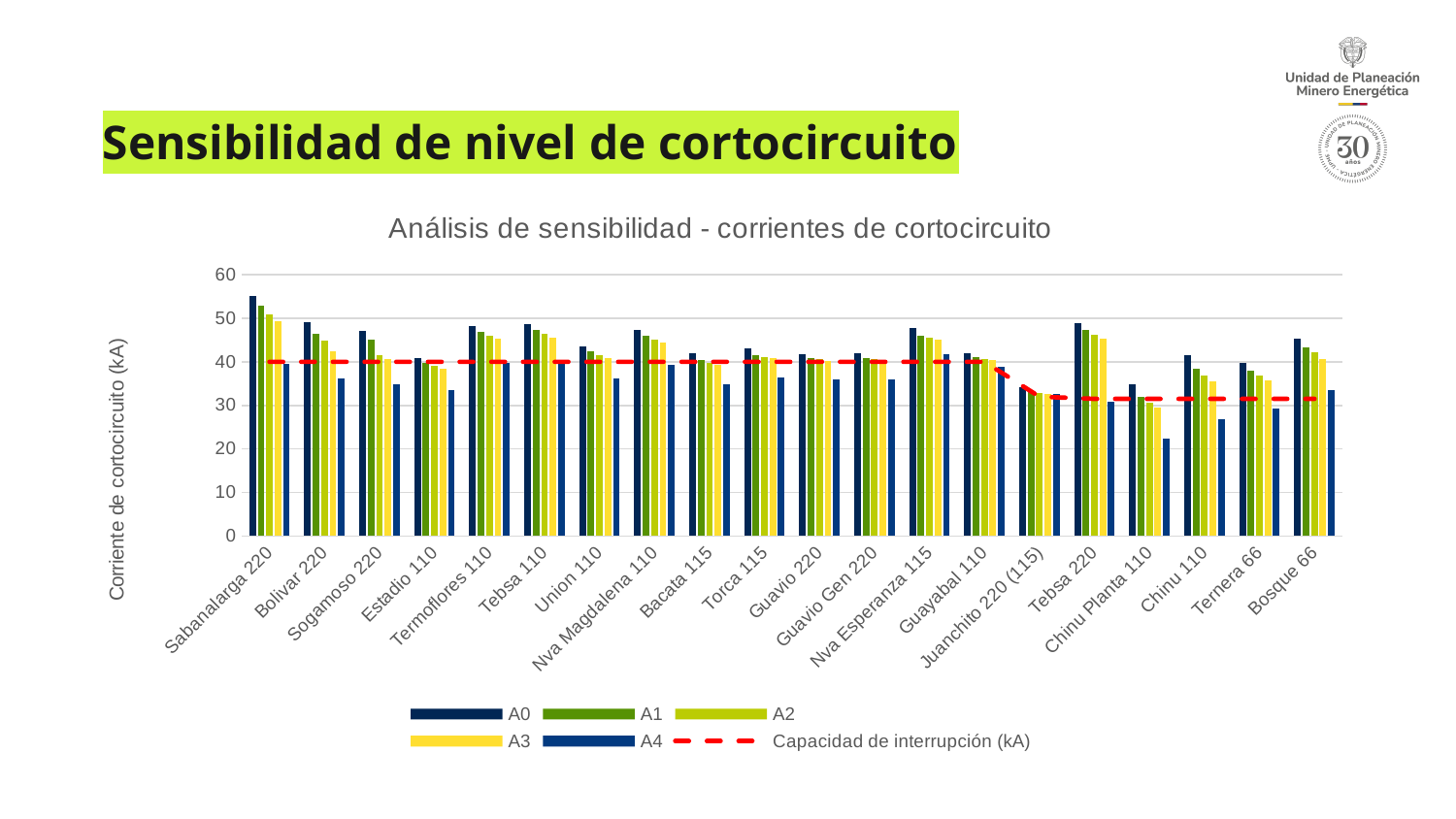
Is the A0 value for Juanchito 220 (115) greater or less than 40? less Is the A4 value for Bolivar 220 greater or less than 40? less Which category has the highest A0 value? Sabanalarga 220 Is the A4 value for Chinu Planta 110 greater or less than 30? less What kind of chart is shown on the slide? combination bar and line chart Which legend entry is drawn as a red dashed line? Capacidad de interrupción (kA) How many series does the chart legend list? 6 How many categories are shown along the x axis of the chart? 20 Which category has the lowest A4 value? Chinu Planta 110 What is the title of the chart? Análisis de sensibilidad - corrientes de cortocircuito